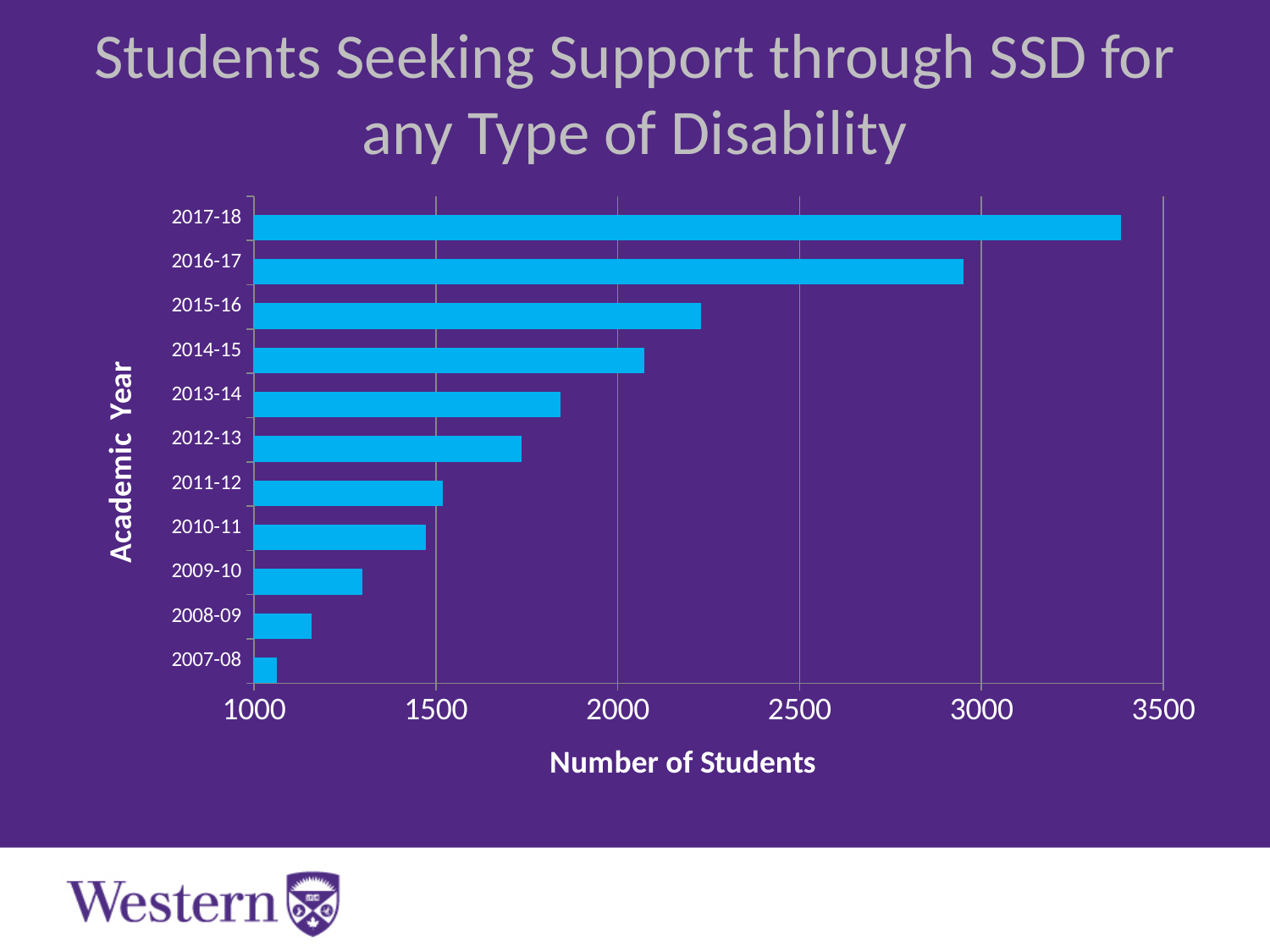
Is the value for 2009-10 greater or less than 1500? less Is the value for 2013-14 greater or less than 2000? less What kind of chart is shown on the slide? bar chart Which academic year has the highest number of students? 2017-18 Is the value for 2015-16 greater or less than 2000? greater How many academic years are plotted on the chart? 11 Do the number of students rise or fall from 2007-08 to 2017-18? rise Which has more students, 2014-15 or 2012-13? 2014-15 Which academic year has the lowest number of students? 2007-08 What is the label of the horizontal axis? Number of Students